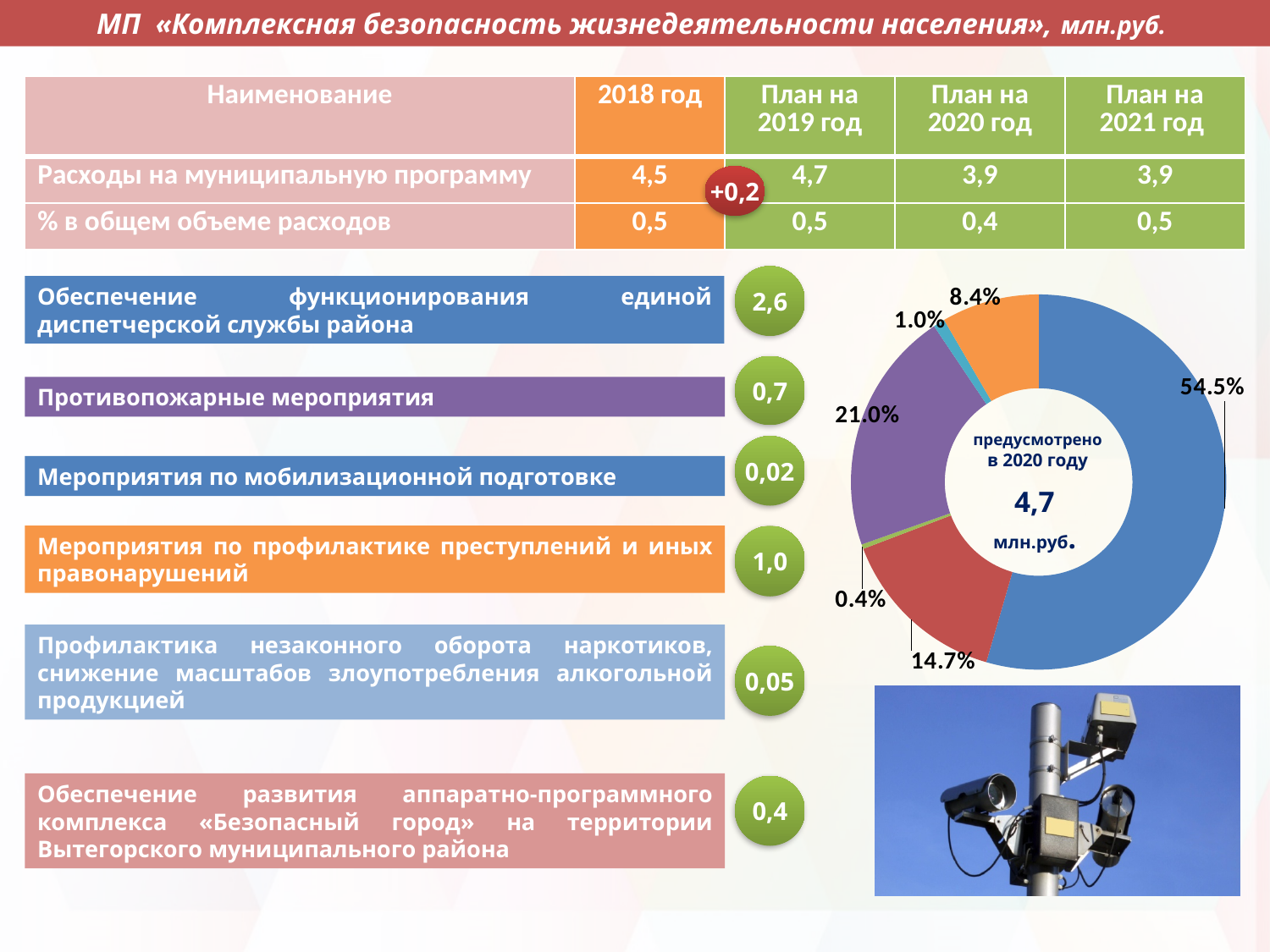
What share is shown for the purple slice of the doughnut chart? 21.0% What total amount is printed in the centre of the doughnut chart? 4,7 млн.руб. What is the share of the smallest slice in the doughnut chart? 0.4% What is the combined share of the 1.0% and 8.4% slices in the doughnut chart? 9.4% How many slices does the doughnut chart have? 6 What share is shown for the orange slice of the doughnut chart? 8.4% According to the centre text of the doughnut chart, for which year is the amount planned? 2020 What share is shown for the red slice of the doughnut chart? 14.7% What kind of chart is shown on the right side of the slide? Doughnut (pie) chart What is the difference in percentage points between the 54.5% slice and the 21.0% slice? 33.5 Which slice is larger in the doughnut chart: the one labelled 14.7% or the one labelled 8.4%? 14.7% What is the share of the largest slice in the doughnut chart? 54.5%